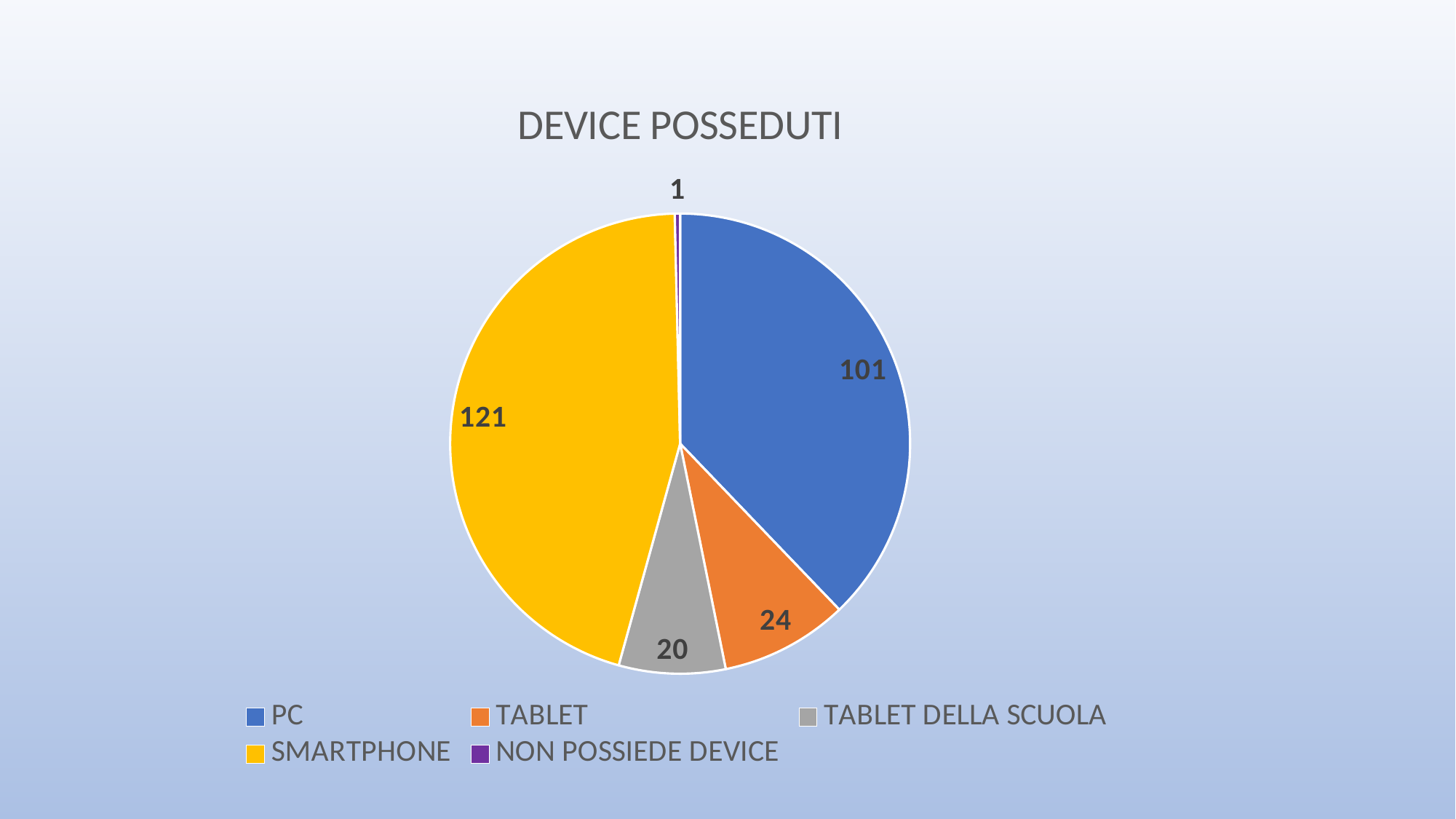
Which is larger, TABLET or TABLET DELLA SCUOLA? TABLET How many categories does the pie chart have? 5 What is the value for NON POSSIEDE DEVICE? 1 What is the value for SMARTPHONE? 121 Which category has the largest slice? SMARTPHONE What is the title of the chart? DEVICE POSSEDUTI Which category has the smallest slice? NON POSSIEDE DEVICE What type of chart is shown on the slide? pie chart What is the difference between the values for SMARTPHONE and PC? 20 What is the value for TABLET DELLA SCUOLA? 20 What is the value for PC? 101 What colour is the slice for TABLET? orange